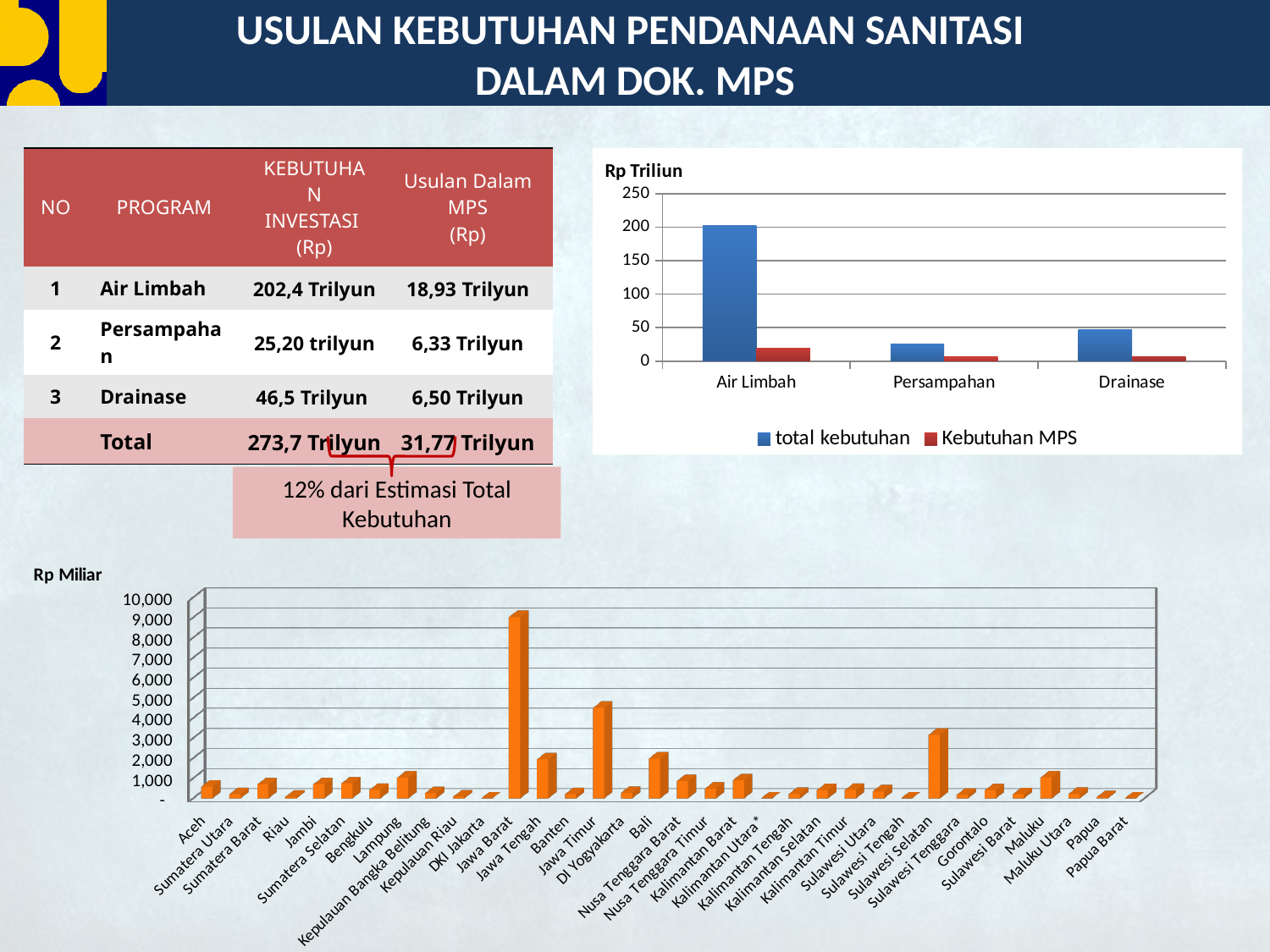
In the top-right chart (Rp Triliun), is the 'Kebutuhan MPS' value for Air Limbah greater or less than 50? less What kind of chart is the bottom chart (Rp Miliar)? bar chart In the top-right chart (Rp Triliun), which category has the highest value for the 'total kebutuhan' series? Air Limbah In the top-right chart (Rp Triliun), is the 'total kebutuhan' value for Air Limbah greater or less than 150? greater In the bottom chart (Rp Miliar), which has the larger value, Jawa Timur or Sulawesi Selatan? Jawa Timur How many series does the legend of the top-right chart (Rp Triliun) list? 2 In the top-right chart (Rp Triliun), is the 'total kebutuhan' value for Drainase greater or less than 100? less What are the two legend entries of the top-right chart (Rp Triliun)? total kebutuhan and Kebutuhan MPS In the top-right chart (Rp Triliun), which category has the lowest value for the 'total kebutuhan' series? Persampahan In the bottom chart (Rp Miliar), which province has the highest value? Jawa Barat In the top-right chart (Rp Triliun), which has the larger 'total kebutuhan' value, Persampahan or Drainase? Drainase